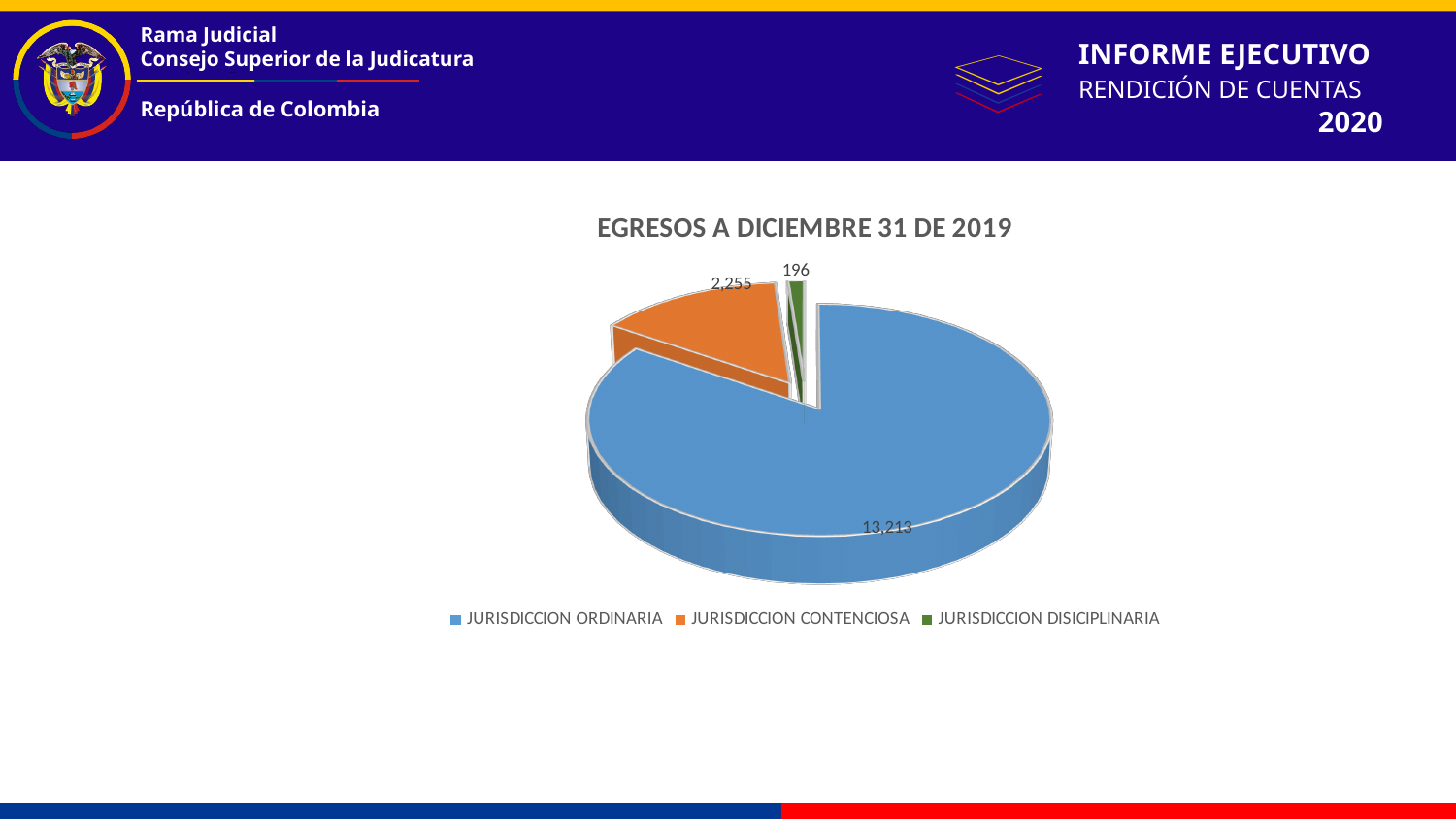
What is the value for JURISDICCION CONTENCIOSA? 2,255 What colour is the slice for JURISDICCION CONTENCIOSA? Orange Which category has the largest slice of the pie? JURISDICCION ORDINARIA What is the difference between the values for JURISDICCION CONTENCIOSA and JURISDICCION DISICIPLINARIA? 2,059 What is the value for JURISDICCION DISICIPLINARIA? 196 How many categories does the pie chart show? 3 What is the value for JURISDICCION ORDINARIA? 13,213 Which is larger, JURISDICCION CONTENCIOSA or JURISDICCION DISICIPLINARIA? JURISDICCION CONTENCIOSA What is the difference between the values for JURISDICCION ORDINARIA and JURISDICCION CONTENCIOSA? 10,958 What type of chart is shown on the slide? Pie chart What is the title of the chart? EGRESOS A DICIEMBRE 31 DE 2019 Which category has the smallest slice of the pie? JURISDICCION DISICIPLINARIA